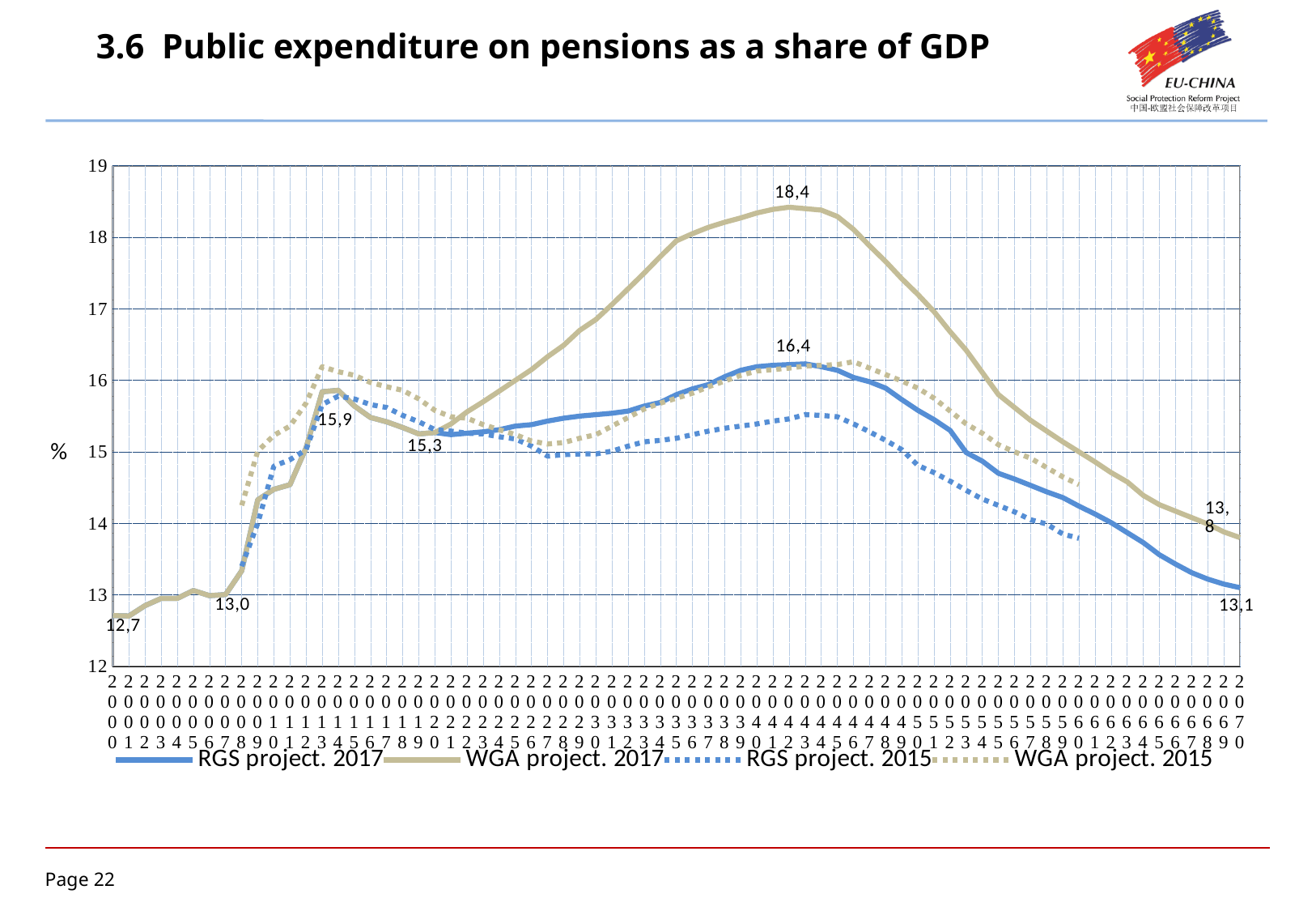
Is the value of the WGA project. 2017 series in 2030 greater or less than 16? greater Which series reaches the highest value on the chart? WGA project. 2017 What unit is shown on the y axis label? % What is the labelled peak value of the RGS project. 2017 series? 16,4 What is the labelled peak value of the WGA project. 2017 series? 18,4 What is the difference between the labelled peaks of the WGA project. 2017 (18,4) and RGS project. 2017 (16,4) series? 2,0 In 2070, which series is higher: WGA project. 2017 or RGS project. 2017? WGA project. 2017 What value is labelled for the WGA project. 2017 series in 2070? 13,8 What type of chart is shown on the slide? line chart What value is labelled for the RGS project. 2017 series in 2070? 13,1 How many series does the legend list? 4 What value is labelled at the start of the series in 2000? 12,7